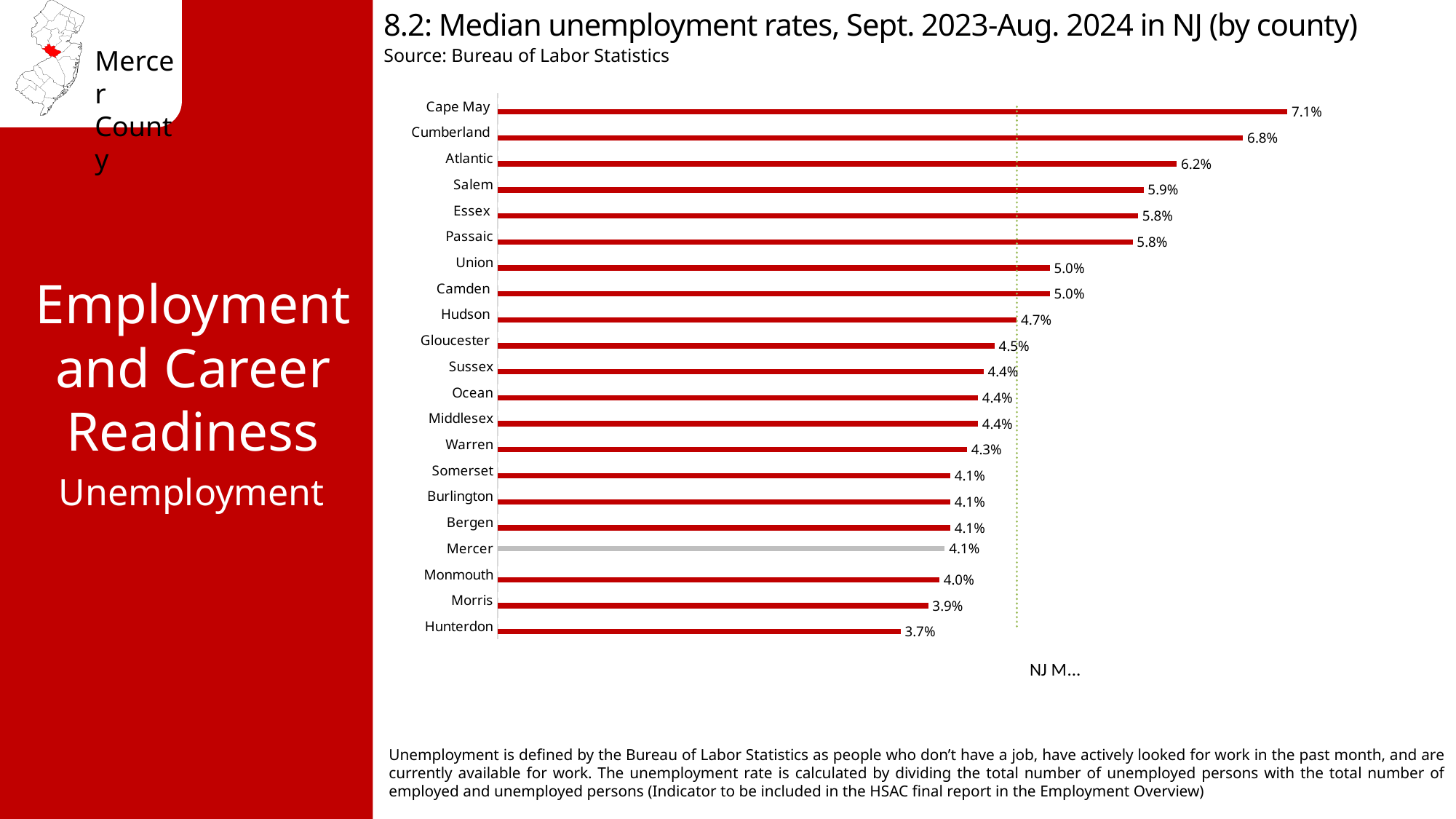
Which county has the lowest median unemployment rate? Hunterdon Which county has a higher median unemployment rate, Gloucester or Morris? Gloucester What is the median unemployment rate for Mercer? 4.1% How many counties are shown in the chart? 21 What is the median unemployment rate for Hudson? 4.7% What type of chart is used to show the median unemployment rates? Bar chart Which county's bar is shown in grey instead of red? Mercer What is the median unemployment rate for Cape May? 7.1% Which county has the highest median unemployment rate? Cape May What is the difference between the median unemployment rates of Cumberland and Atlantic? 0.6% What is the difference between the median unemployment rates of Cape May and Hunterdon? 3.4% Which county has a higher median unemployment rate, Salem or Union? Salem